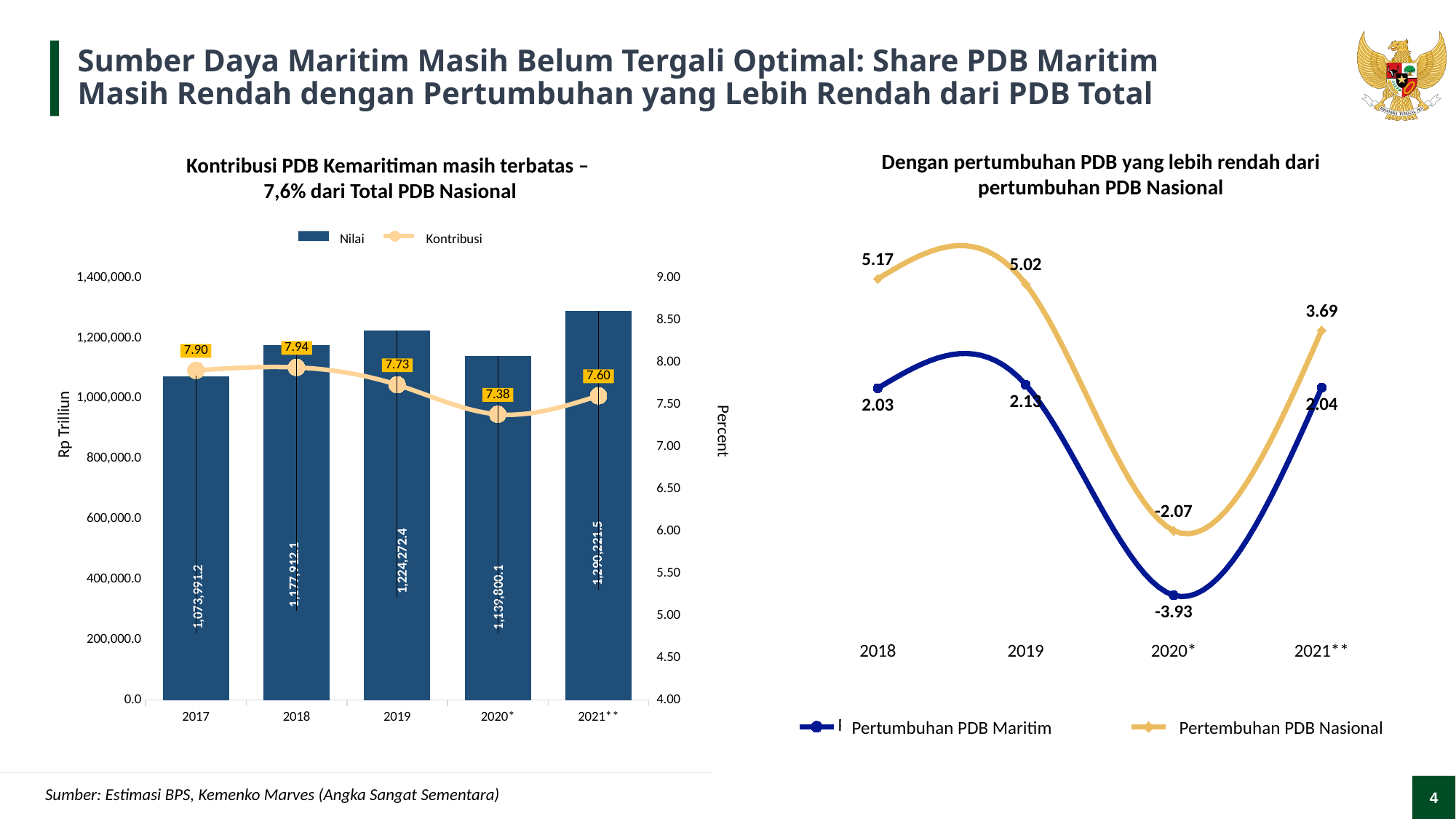
In the left chart, how many series does the legend list? 2 In the left chart, how many years are shown on the x axis? 5 In the left chart, what is the Kontribusi value for 2017? 7.90 In the right chart, what is the Pertumbuhan PDB Maritim value for 2020*? -3.93 In the right chart, what is the difference between Pertembuhan PDB Nasional and Pertumbuhan PDB Maritim in 2021**? 1.65 In the left chart, which year has the highest Kontribusi value? 2018 In the left chart, is the Nilai bar for 2021** greater or less than 1,200,000.0? greater What kind of chart is the right chart? line chart In the left chart, which year has the lowest Kontribusi value? 2020* In the right chart, what is the Pertembuhan PDB Nasional value for 2021**? 3.69 In the left chart, what is the difference between the Kontribusi values for 2018 and 2020*? 0.56 In the right chart, which series has the larger value in 2018, Pertumbuhan PDB Maritim or Pertembuhan PDB Nasional? Pertembuhan PDB Nasional